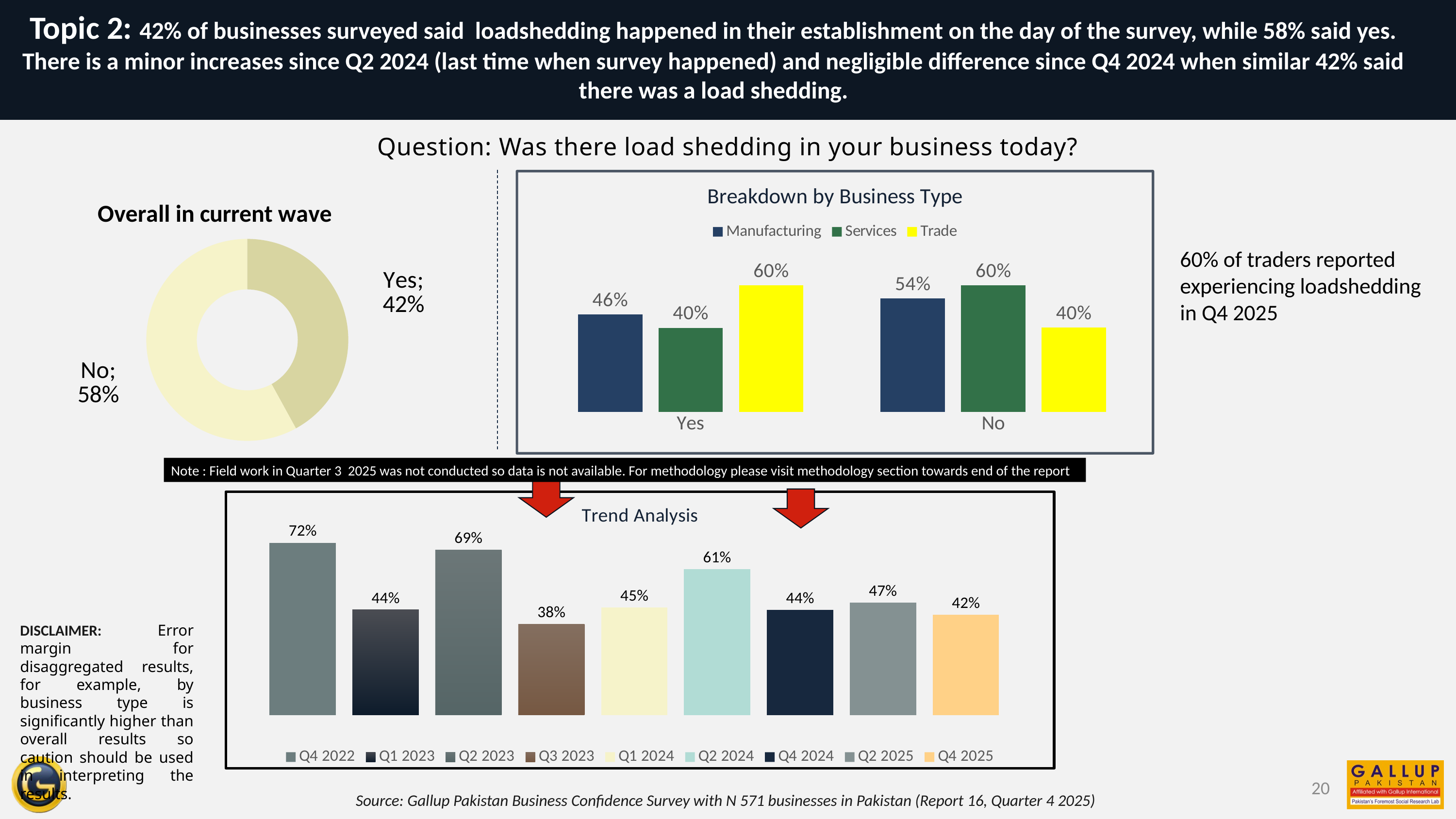
In the "Overall in current wave" chart, what share of businesses said Yes? 42% In the "Overall in current wave" chart, what share of businesses said No? 58% In the "Breakdown by Business Type" chart, what is the value for Manufacturing under No? 54% In the "Trend Analysis" chart, is the value for Q2 2024 larger or smaller than the value for Q2 2025? Larger In the "Breakdown by Business Type" chart, which business type has the lowest value under Yes? Services In the "Trend Analysis" chart, how many quarters are plotted? 9 In the "Breakdown by Business Type" chart, what is the difference between Trade and Services under Yes? 20% In the "Breakdown by Business Type" chart, how many series does the legend list? 3 What kind of chart is "Overall in current wave"? Pie chart (donut) In the "Trend Analysis" chart, what is the value for Q4 2022? 72% In the "Breakdown by Business Type" chart, what is the value for Trade under Yes? 60% In the "Trend Analysis" chart, which quarter has the lowest value? Q3 2023